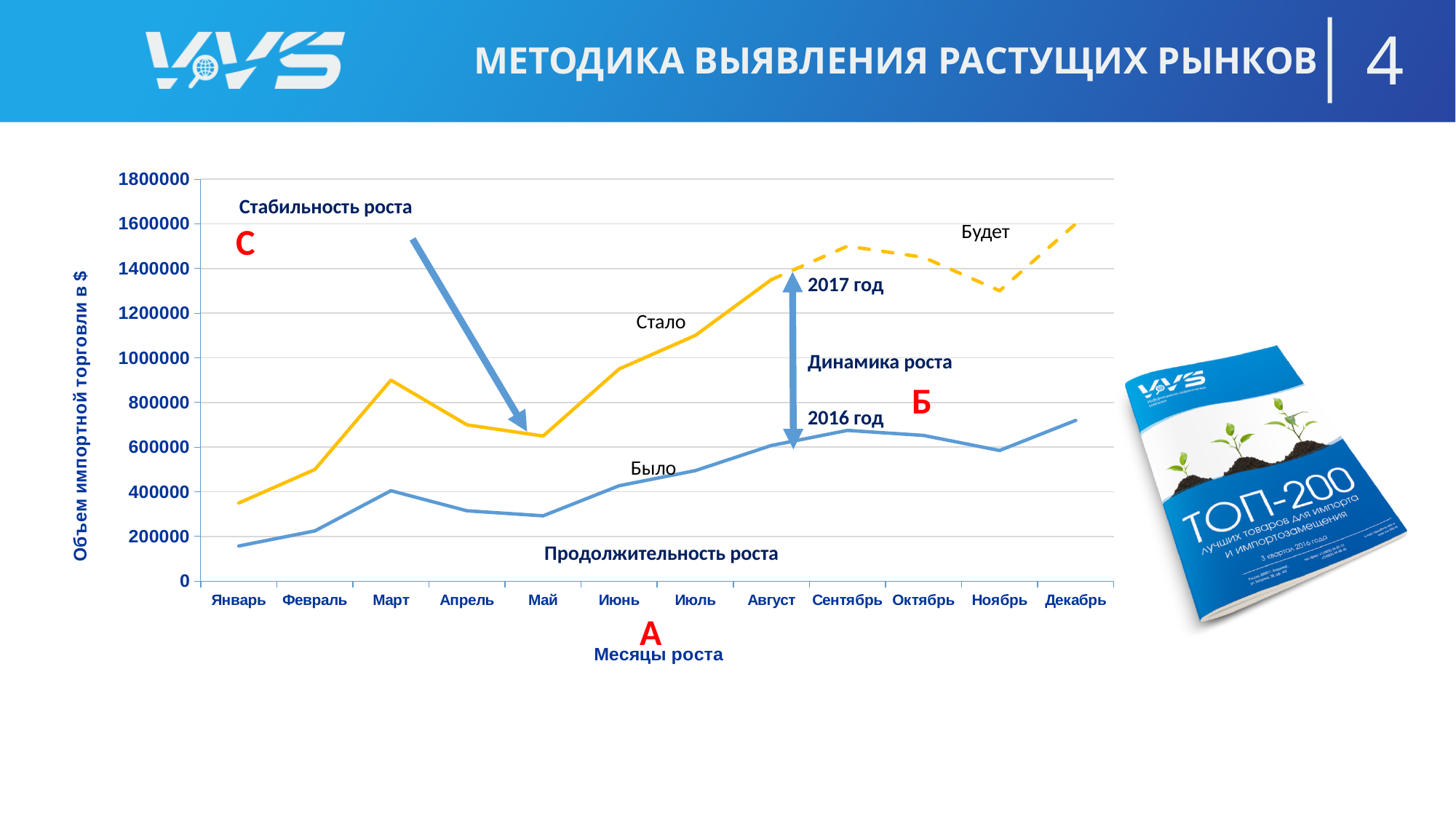
How many months are shown along the x axis of the chart? 12 What is the title of the horizontal axis of the chart? Месяцы роста What is the title of the vertical axis of the chart? Объем импортной торговли в $ Is the value of the 'Стало' line for Март greater or less than 800000? greater What kind of chart is shown on the slide? line chart For Март, which line has the larger value, 'Стало' or 'Было'? Стало In which month does the 'Было' line reach its highest value? Декабрь Is the value of the 'Было' line for Май greater or less than 400000? less Is the value of the 'Было' line for Январь greater or less than 200000? less In which month does the 'Было' line have its lowest value? Январь